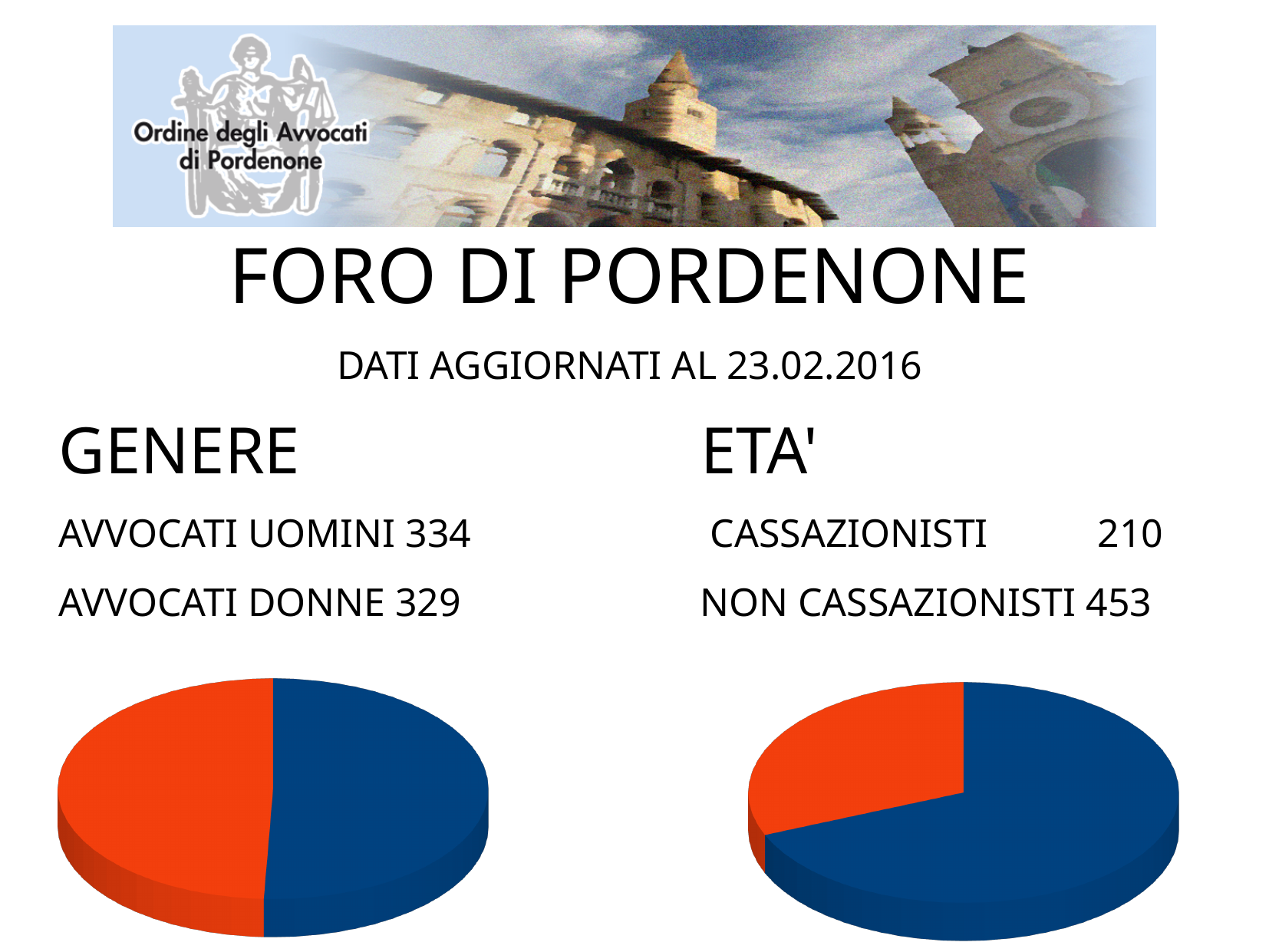
In the GENERE section, what is the value for AVVOCATI UOMINI? 334 In the ETA' section, what is the value for CASSAZIONISTI? 210 In the ETA' section, what is the difference between NON CASSAZIONISTI and CASSAZIONISTI? 243 What kind of chart is shown under the ETA' heading? pie chart How many pie charts are on the slide? 2 In the ETA' section, what is the value for NON CASSAZIONISTI? 453 In the ETA' section, which category has the larger value, CASSAZIONISTI or NON CASSAZIONISTI? NON CASSAZIONISTI In the ETA' pie chart, which slice is larger, the blue one or the orange one? the blue one In the GENERE section, what is the value for AVVOCATI DONNE? 329 What kind of chart is shown under the GENERE heading? pie chart How many slices does the ETA' pie chart have? 2 How many slices does the GENERE pie chart have? 2